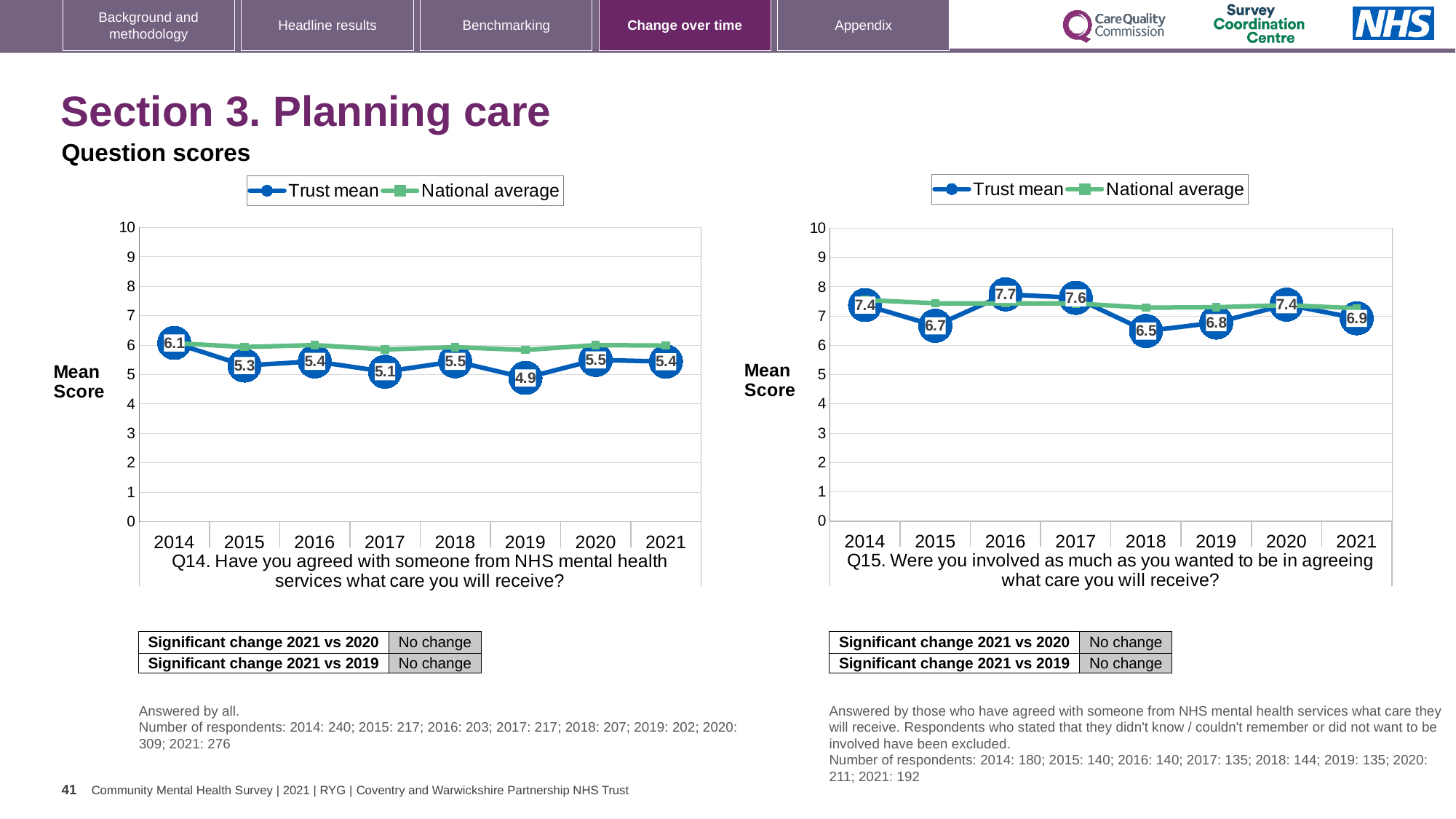
In the Q14 chart on the left, is the National average for 2021 greater or less than 5? greater In the Q15 chart on the right, is the Trust mean higher in 2017 or in 2018? 2017 In the Q14 chart on the left, what is the Trust mean for 2019? 4.9 How many years are shown on the x axis of the Q14 chart on the left? 8 In the Q14 chart on the left, what is the difference between the Trust mean in 2014 and in 2019? 1.2 In the Q15 chart on the right, which year has the lowest Trust mean? 2018 In the Q15 chart on the right, which year has the highest Trust mean? 2016 In the Q14 chart on the left, what is the Trust mean for 2014? 6.1 In the Q15 chart on the right, what is the Trust mean for 2021? 6.9 In the Q15 chart on the right, what is the Trust mean for 2016? 7.7 In the Q14 chart on the left, which year has the lowest Trust mean? 2019 How many series does the legend of the Q15 chart on the right list? 2